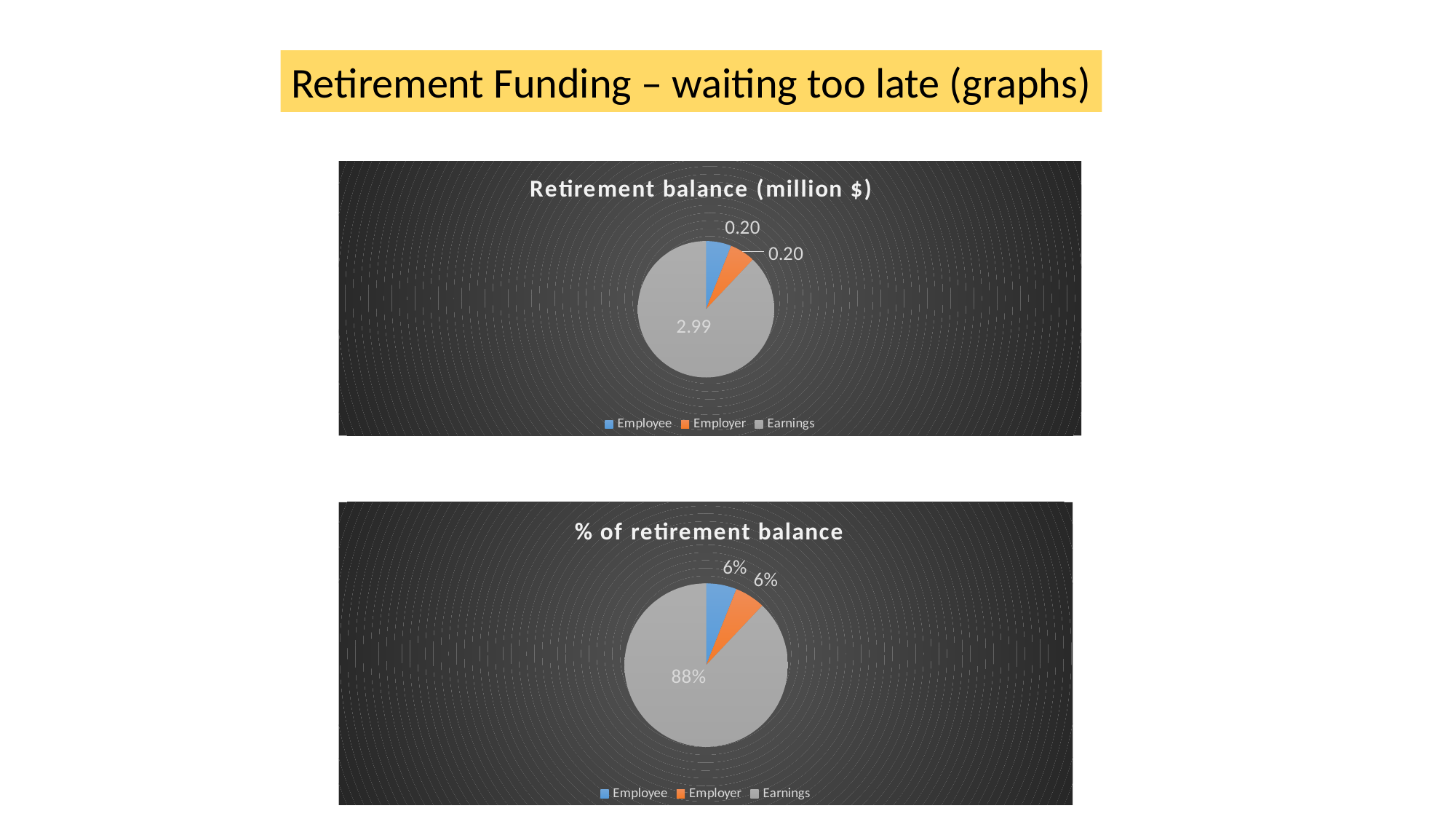
In the '% of retirement balance' chart, what share does Employer have? 6% In the '% of retirement balance' chart, which colour represents Employer in the legend? orange In the 'Retirement balance (million $)' chart, what is the difference between the Earnings value and the Employer value? 2.79 In the 'Retirement balance (million $)' chart, which category has the largest slice? Earnings In the 'Retirement balance (million $)' chart, is the Earnings value larger or smaller than the Employee value? larger In the 'Retirement balance (million $)' chart, what is the value for Earnings? 2.99 What kind of chart is the 'Retirement balance (million $)' chart? pie chart In the '% of retirement balance' chart, what share does Earnings have? 88% In the '% of retirement balance' chart, what is the difference between the Earnings share and the Employee share? 82% How many slices does the '% of retirement balance' chart have? 3 In the 'Retirement balance (million $)' chart, what is the value for Employee? 0.20 How many entries does the legend of the 'Retirement balance (million $)' chart list? 3